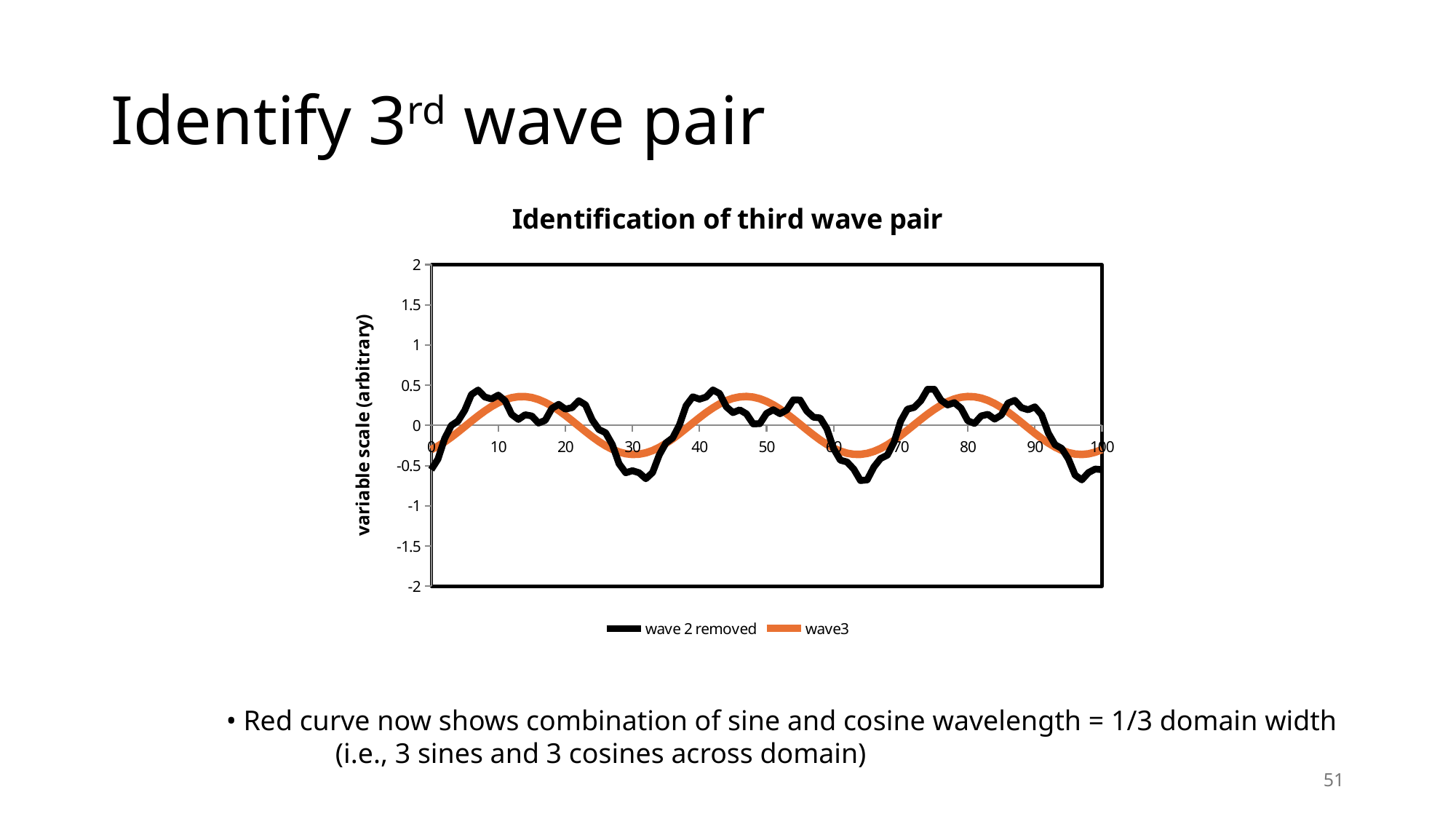
Is the lowest value reached by 'wave 2 removed' greater or less than -1? greater What is the label on the vertical axis of the chart? variable scale (arbitrary) Between x = 60 and x = 80, does the wave3 curve rise or fall? rise Is the value of wave3 at x = 30 greater or less than 0? less How many series does the legend list? 2 Is the value of wave3 at x = 80 greater or less than 0? greater How many peaks (maxima) does the wave3 curve show across the x axis from 0 to 100? 3 What is the title of the chart? Identification of third wave pair What kind of chart is shown on the slide? line chart At x = 65, which series has the lower value, 'wave 2 removed' or wave3? wave 2 removed